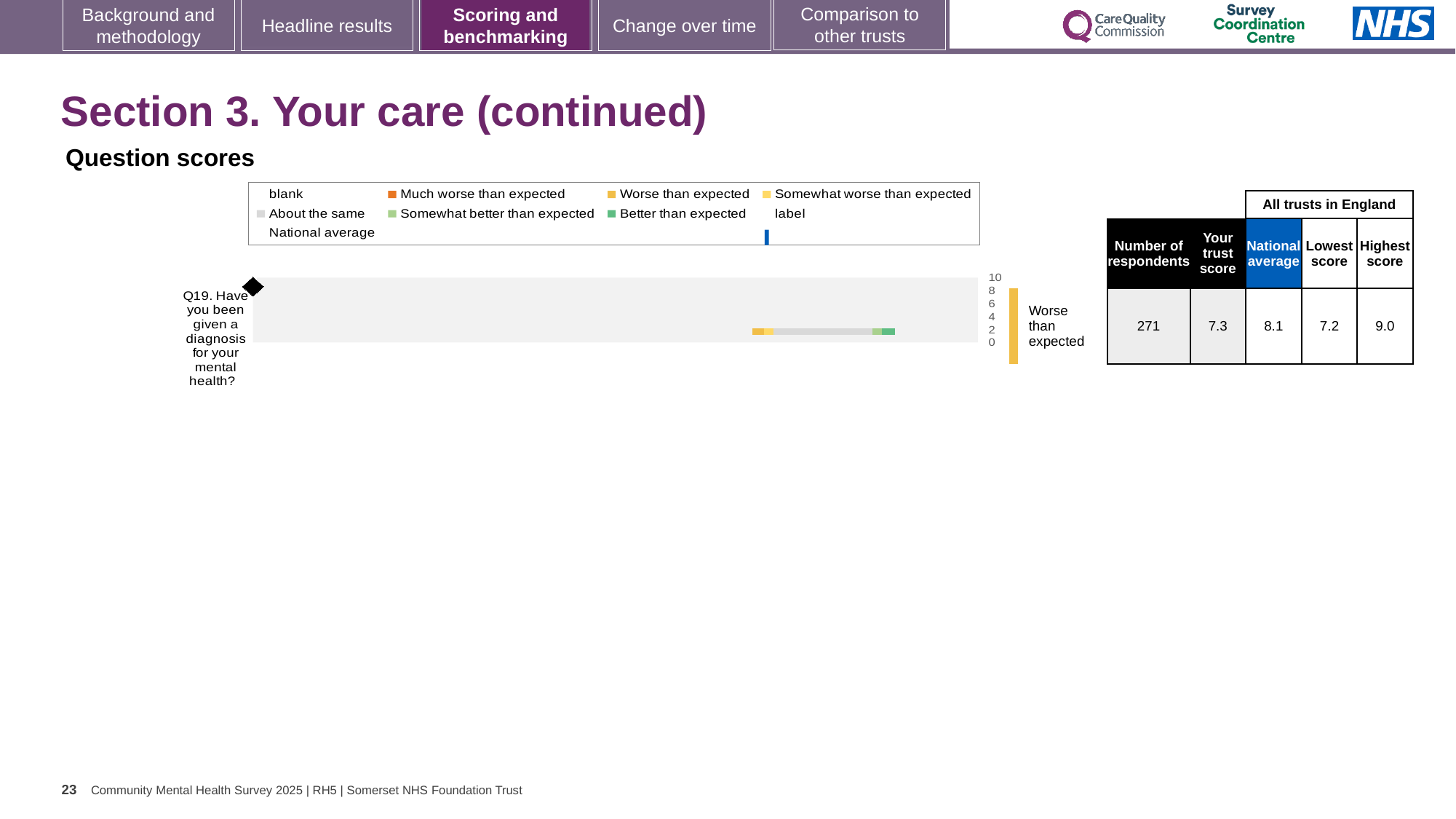
What is the difference between the national average and the trust score for Q19? 0.8 What is the lowest score among all trusts in England for Q19? 7.2 What is the trust score for Q19? 7.3 What is the national average for Q19? 8.1 What benchmarking category is Q19 assigned to in the chart? Worse than expected How many respondents answered Q19? 271 What is the difference between the highest and lowest scores among all trusts in England for Q19? 1.8 Which question is shown in the Question scores chart? Q19. Have you been given a diagnosis for your mental health? How many questions are plotted in the Question scores chart? 1 Which is larger for Q19, the trust score or the national average? National average What kind of chart is used for the Question scores? Bar chart What is the highest score among all trusts in England for Q19? 9.0